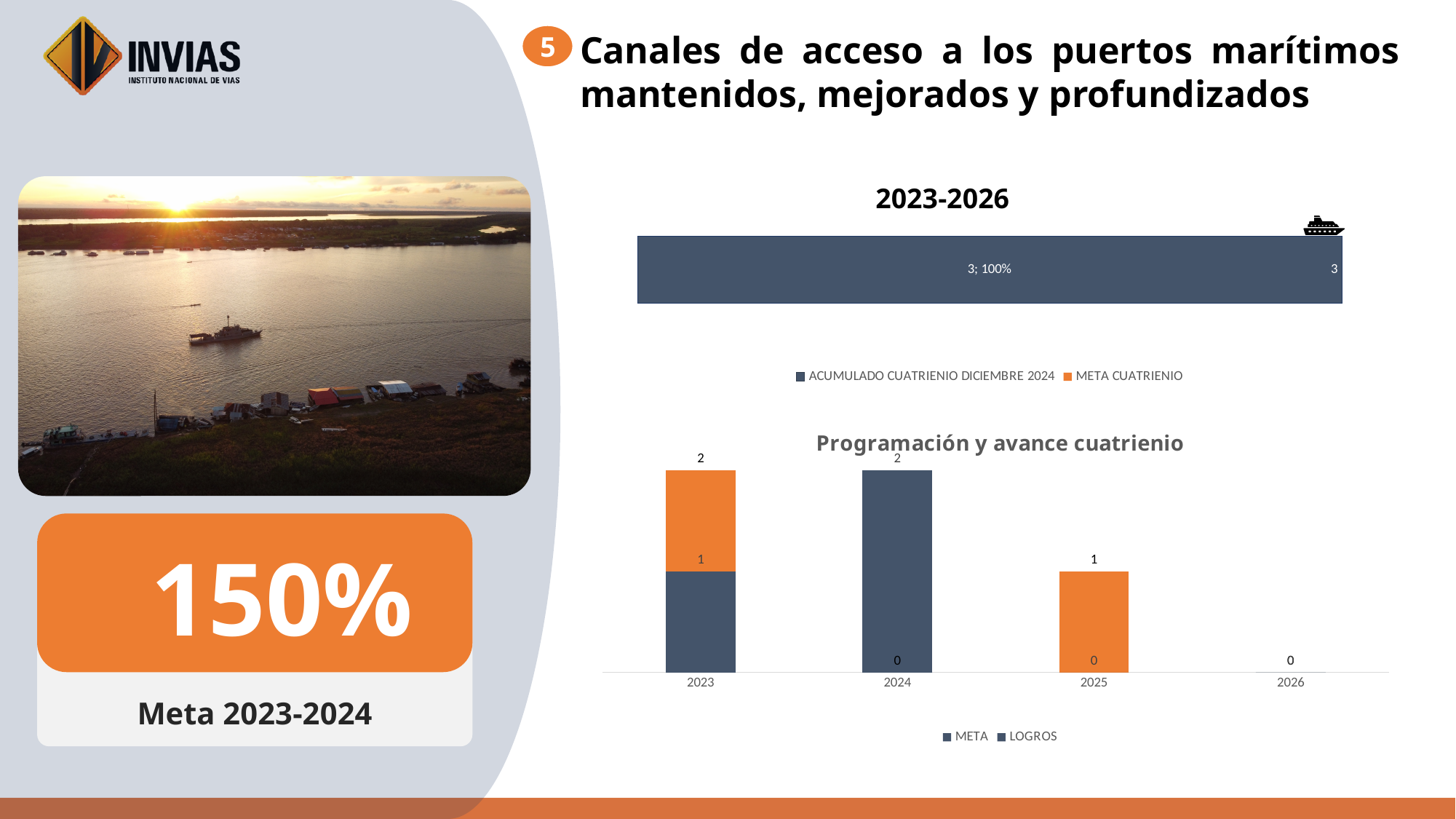
In the '2023-2026' chart at the top, what data label is printed in the middle of the bar? 3; 100% How many series does the legend of the 'Programación y avance cuatrienio' chart list? 2 In the 'Programación y avance cuatrienio' chart, what is the top data label on the 2024 bar? 2 What kind of chart is the '2023-2026' chart at the top of the slide? bar chart In the 'Programación y avance cuatrienio' chart, what is the top data label on the 2025 bar? 1 In the 'Programación y avance cuatrienio' chart, which year has the lowest bar? 2026 In the 'Programación y avance cuatrienio' chart, which bar is taller, 2024 or 2025? 2024 In the 'Programación y avance cuatrienio' chart, what is the value shown for 2026? 0 In the 'Programación y avance cuatrienio' chart, how many years are shown on the x axis? 4 What are the legend entries of the 'Programación y avance cuatrienio' chart? META, LOGROS What kind of chart is the 'Programación y avance cuatrienio' chart? bar chart How many series does the legend of the '2023-2026' chart list? 2